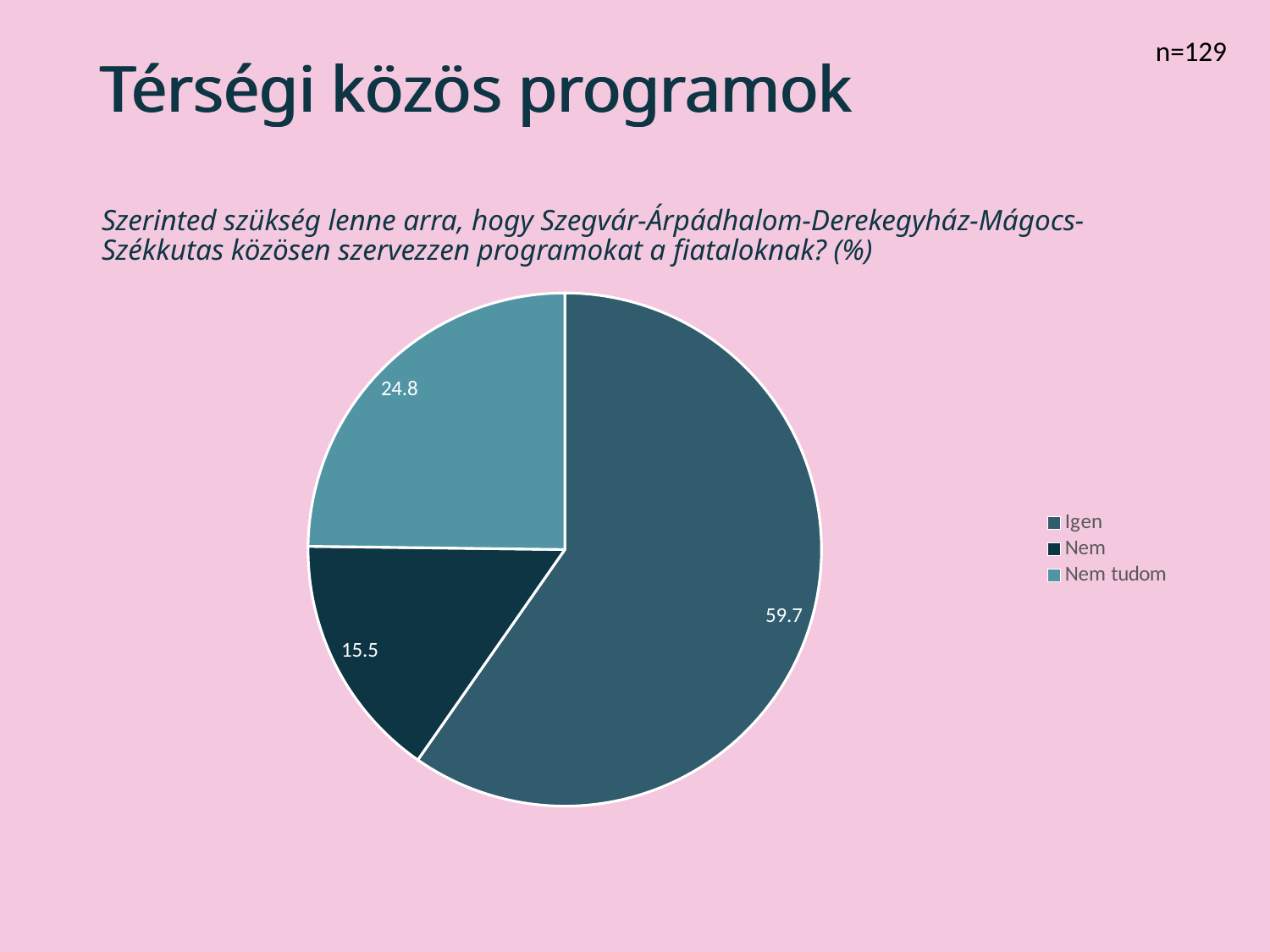
How many slices does the pie chart have? 3 What sample size (n) is shown on the slide? n=129 What is the value for Nem tudom? 24.8 What is the value for Igen? 59.7 What is the difference between the values for Nem tudom and Nem? 9.3 What is the difference between the values for Igen and Nem tudom? 34.9 What is the value for Nem? 15.5 Which category has the largest slice? Igen What kind of chart is shown on the slide? pie chart How many entries does the legend list? 3 Which category has the smallest slice? Nem Which is larger, the value for Nem tudom or the value for Nem? Nem tudom